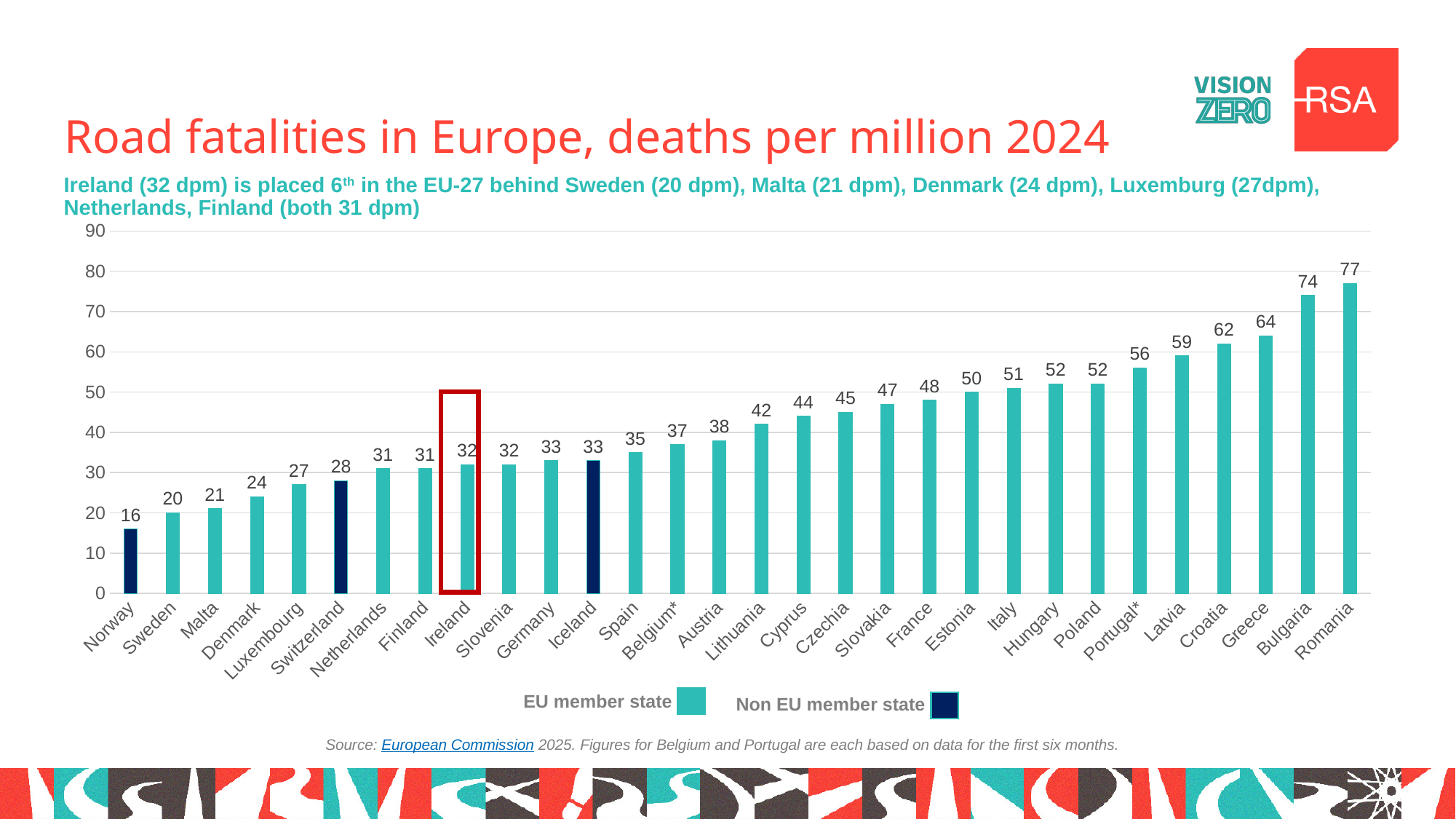
What kind of chart is shown? Bar chart How many countries are shown on the chart? 30 What is the value for Romania? 77 Which legend entry is shown in dark navy? Non EU member state Do the values rise or fall from left to right along the x axis? Rise Which country has the highest deaths per million? Romania Which country has the lowest deaths per million? Norway Which has a higher value, Spain or Austria? Austria What is the difference between the values for Romania and Norway? 61 What is the value for Belgium*? 37 What is the value for Ireland? 32 What is the difference between the values for Bulgaria and Greece? 10